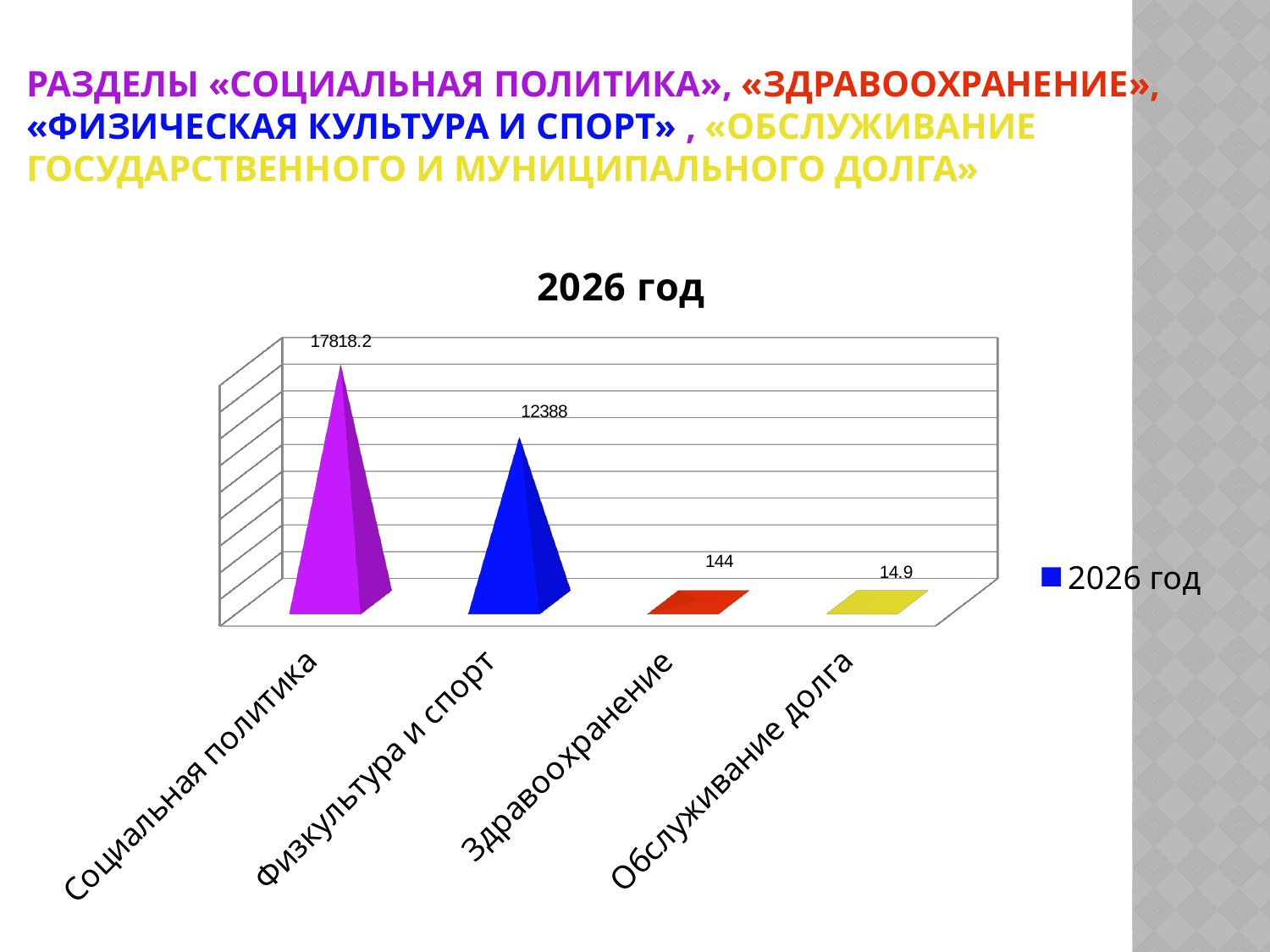
Which is larger, the value for Здравоохранение or the value for Обслуживание долга? Здравоохранение Which category has the lowest value? Обслуживание долга What is the value for Социальная политика? 17818.2 What is the difference between the values for Социальная политика and Физкультура и спорт? 5430.2 What is the value for Обслуживание долга? 14.9 What is the value for Здравоохранение? 144 What type of chart is shown on the slide? bar chart What is the value for Физкультура и спорт? 12388 How many categories are shown on the x axis? 4 Which category has the highest value? Социальная политика What is the title of the chart? 2026 год What is the difference between the values for Здравоохранение and Обслуживание долга? 129.1